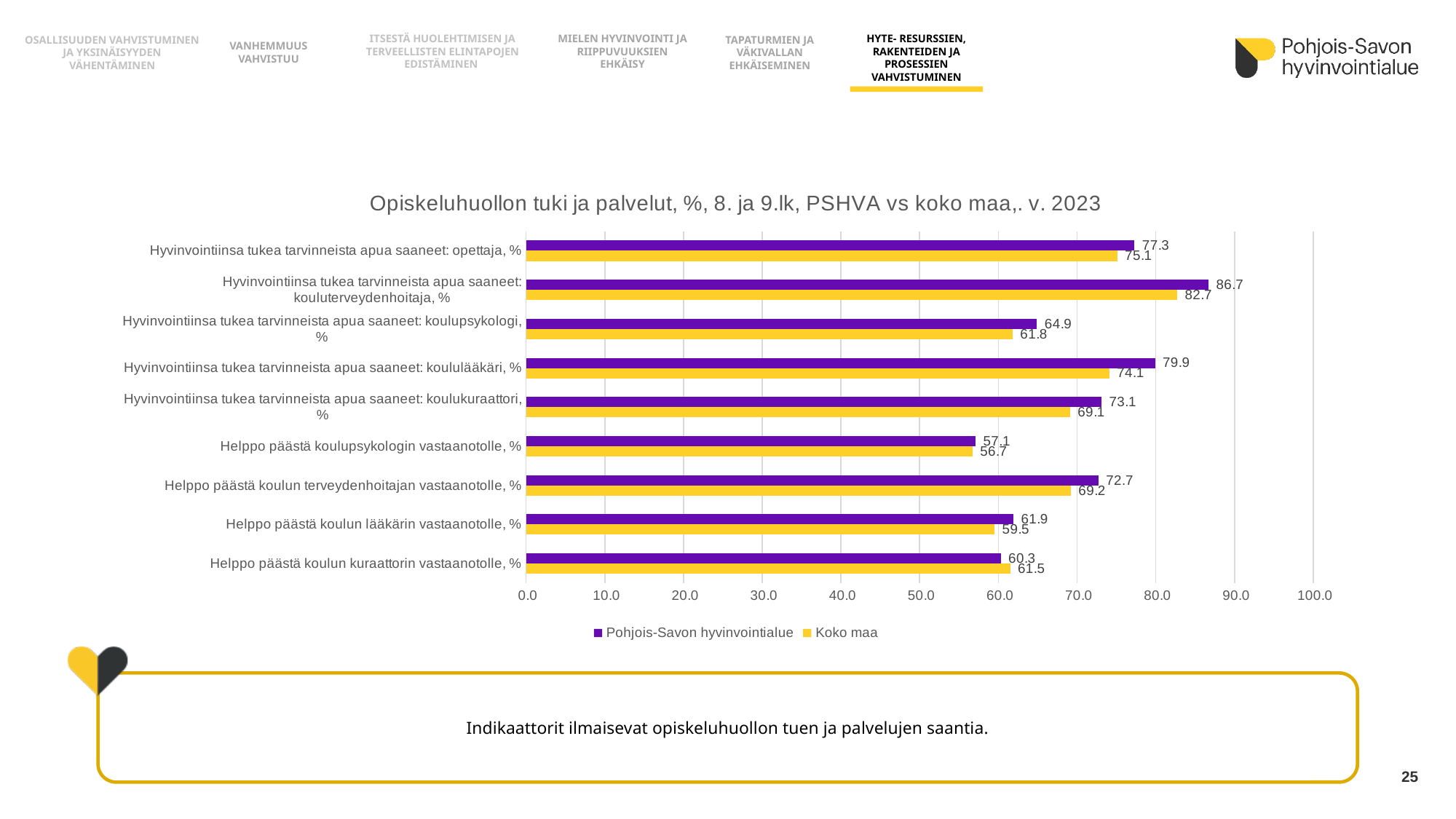
Which category has the lowest value for Koko maa? Helppo päästä koulupsykologin vastaanotolle, % What kind of chart is shown on the slide? Bar chart For "Helppo päästä koulun kuraattorin vastaanotolle, %", which series has the larger value, Pohjois-Savon hyvinvointialue or Koko maa? Koko maa Which category has the highest value for Pohjois-Savon hyvinvointialue? Hyvinvointiinsa tukea tarvinneista apua saaneet: kouluterveydenhoitaja, % Is the value for Koko maa for "Hyvinvointiinsa tukea tarvinneista apua saaneet: opettaja, %" greater or less than 70.0? greater What is the title of the chart? Opiskeluhuollon tuki ja palvelut, %, 8. ja 9.lk, PSHVA vs koko maa,. v. 2023 How many categories are shown on the chart? 9 What is the value for Koko maa for "Helppo päästä koulun lääkärin vastaanotolle, %"? 59.5 What is the value for Koko maa for "Hyvinvointiinsa tukea tarvinneista apua saaneet: koululääkäri, %"? 74.1 What is the difference between Pohjois-Savon hyvinvointialue and Koko maa for "Hyvinvointiinsa tukea tarvinneista apua saaneet: koululääkäri, %"? 5.8 What is the value for Pohjois-Savon hyvinvointialue for "Hyvinvointiinsa tukea tarvinneista apua saaneet: kouluterveydenhoitaja, %"? 86.7 How many series does the legend list? 2